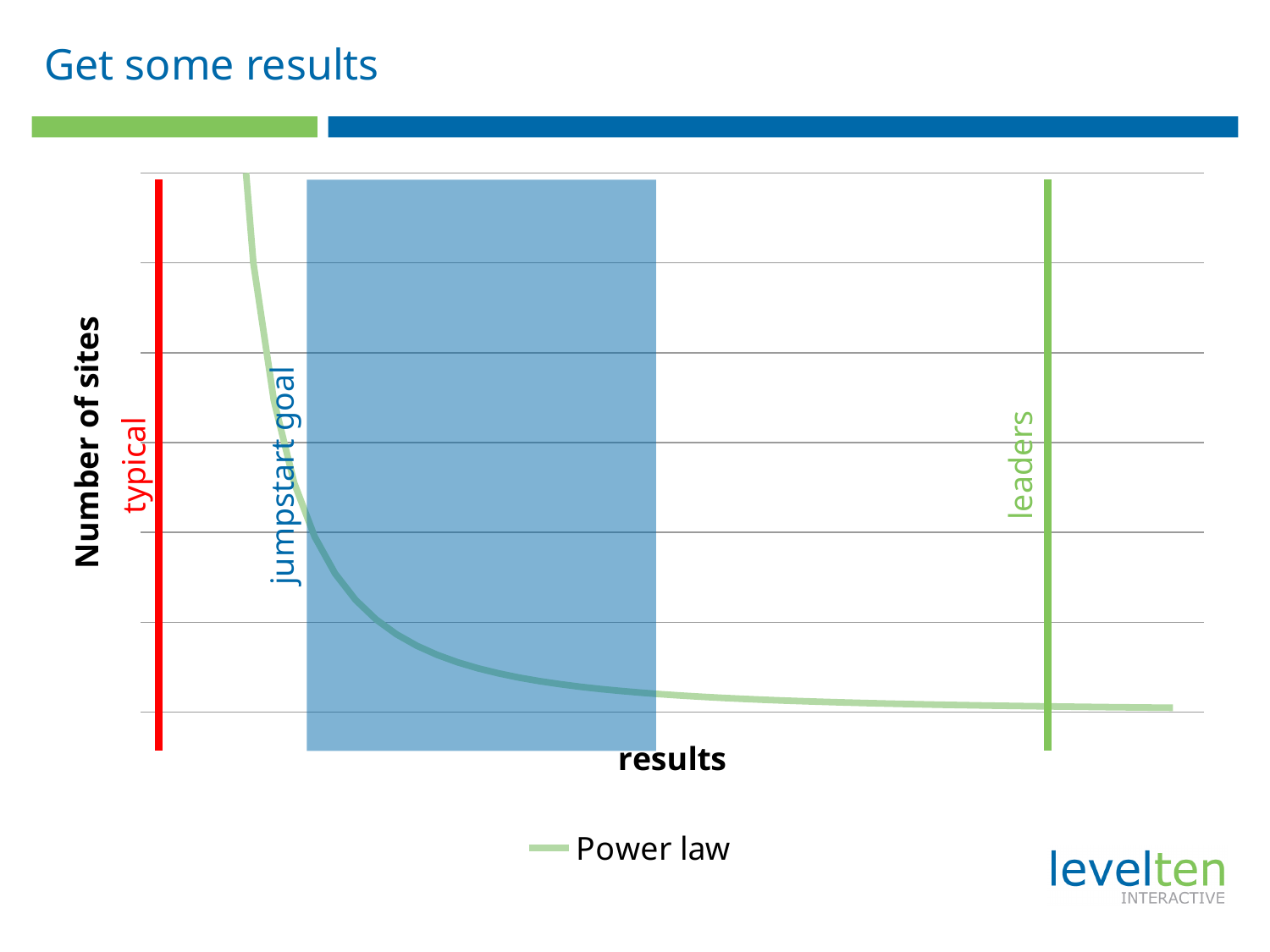
How many series does the legend list? 1 What is the name of the series shown in the legend? Power law Does the Power law line rise or fall as results increase along the x axis? fall What is the title of the vertical axis? Number of sites What kind of chart is shown on the slide? line chart